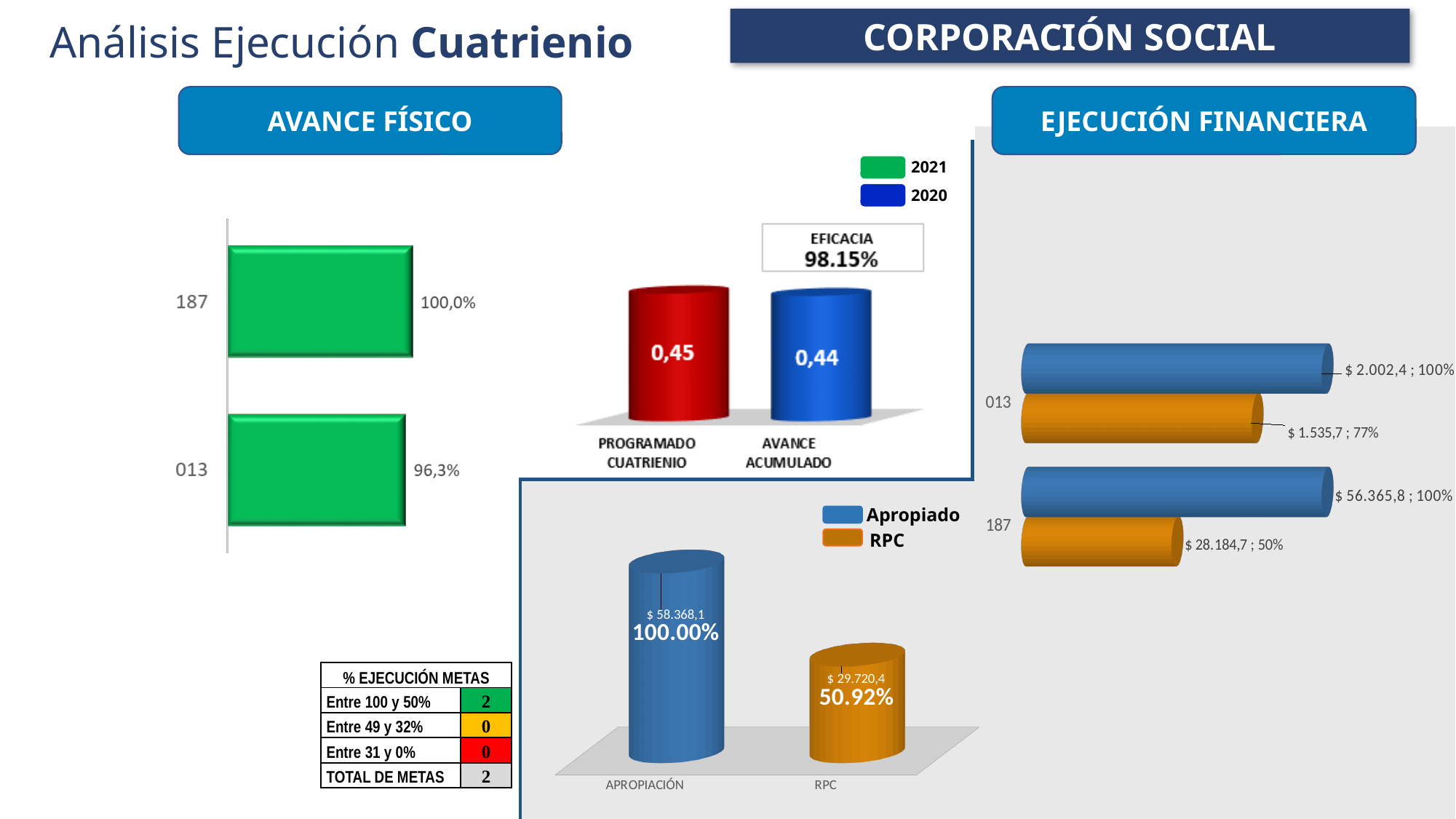
In the EJECUCIÓN FINANCIERA bar chart on the right, how many series does the legend list? 2 In the bottom-middle cylinder chart, what percentage is shown for RPC? 50.92% In the cylinder chart in the top middle, what is the value for PROGRAMADO CUATRIENIO? 0,45 In the cylinder chart in the top middle, what is the difference between PROGRAMADO CUATRIENIO and AVANCE ACUMULADO? 0,01 In the AVANCE FÍSICO bar chart on the left, what is the value for category 013? 96,3% In the AVANCE FÍSICO bar chart on the left, how many categories are shown? 2 In the EJECUCIÓN FINANCIERA bar chart on the right, what is the RPC value for category 187? $ 28.184,7 ; 50% In the AVANCE FÍSICO bar chart on the left, what is the value for category 187? 100,0% In the AVANCE FÍSICO bar chart on the left, which category has the lowest value? 013 In the EJECUCIÓN FINANCIERA bar chart on the right, what is the Apropiado value for category 013? $ 2.002,4 ; 100% In the cylinder chart in the top middle, what is the value for AVANCE ACUMULADO? 0,44 In the bottom-middle cylinder chart, what amount is shown for APROPIACIÓN? $ 58.368,1